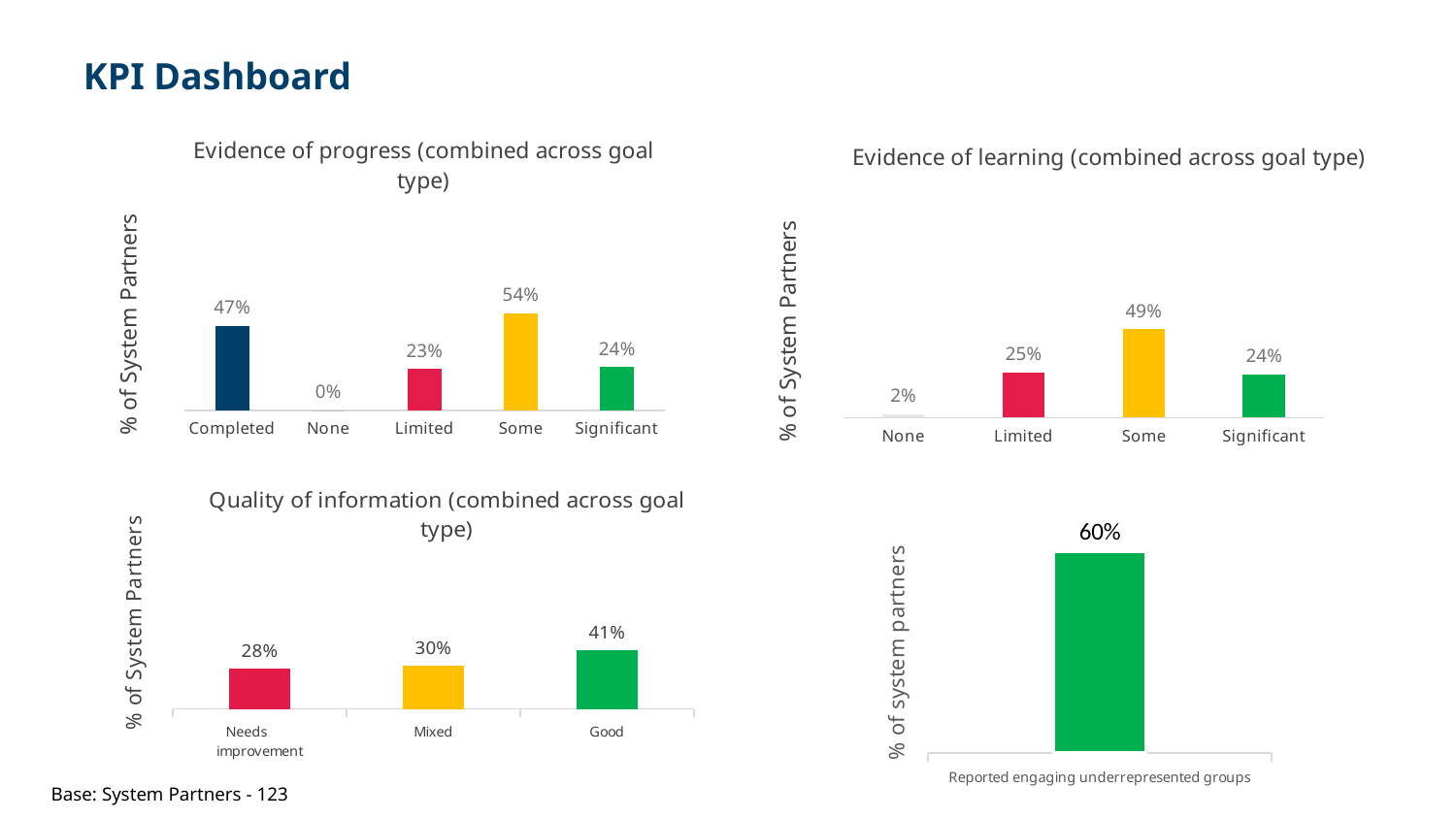
In the 'Evidence of learning (combined across goal type)' chart, what is the value for Limited? 25% In the 'Quality of information (combined across goal type)' chart, which is larger, the value for Needs improvement or the value for Mixed? Mixed In the 'Evidence of progress (combined across goal type)' chart, which category has the lowest value? None In the 'Evidence of progress (combined across goal type)' chart, which category has the highest value? Some In the 'Evidence of learning (combined across goal type)' chart, how many categories are shown on the x axis? 4 In the 'Evidence of progress (combined across goal type)' chart, what is the difference between the values for Some and Significant? 30% In the bottom-right chart, what is the value for 'Reported engaging underrepresented groups'? 60% What kind of chart is the 'Evidence of progress (combined across goal type)' chart? bar chart In the 'Evidence of progress (combined across goal type)' chart, what is the value for Completed? 47% In the 'Evidence of learning (combined across goal type)' chart, which category has the highest value? Some In the 'Quality of information (combined across goal type)' chart, do the values rise or fall from left to right along the x axis? rise In the 'Quality of information (combined across goal type)' chart, what is the value for Good? 41%